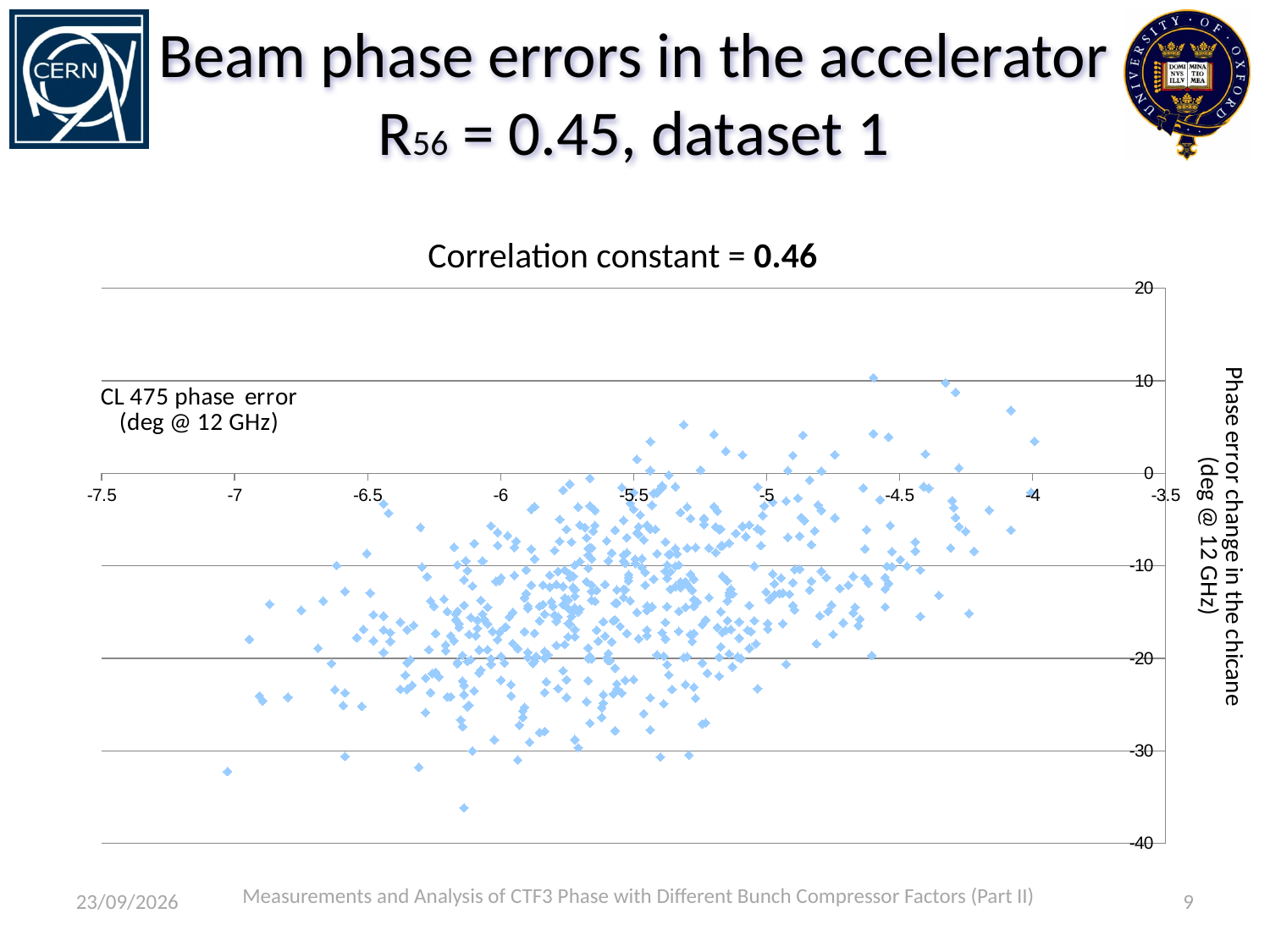
What is the label of the vertical axis of the chart? Phase error change in the chicane (deg @ 12 GHz) Do the plotted points tend to rise or fall as the CL 475 phase error increases along the x axis? rise What correlation constant is stated above the chart? 0.46 What kind of chart is shown on the slide? scatter chart